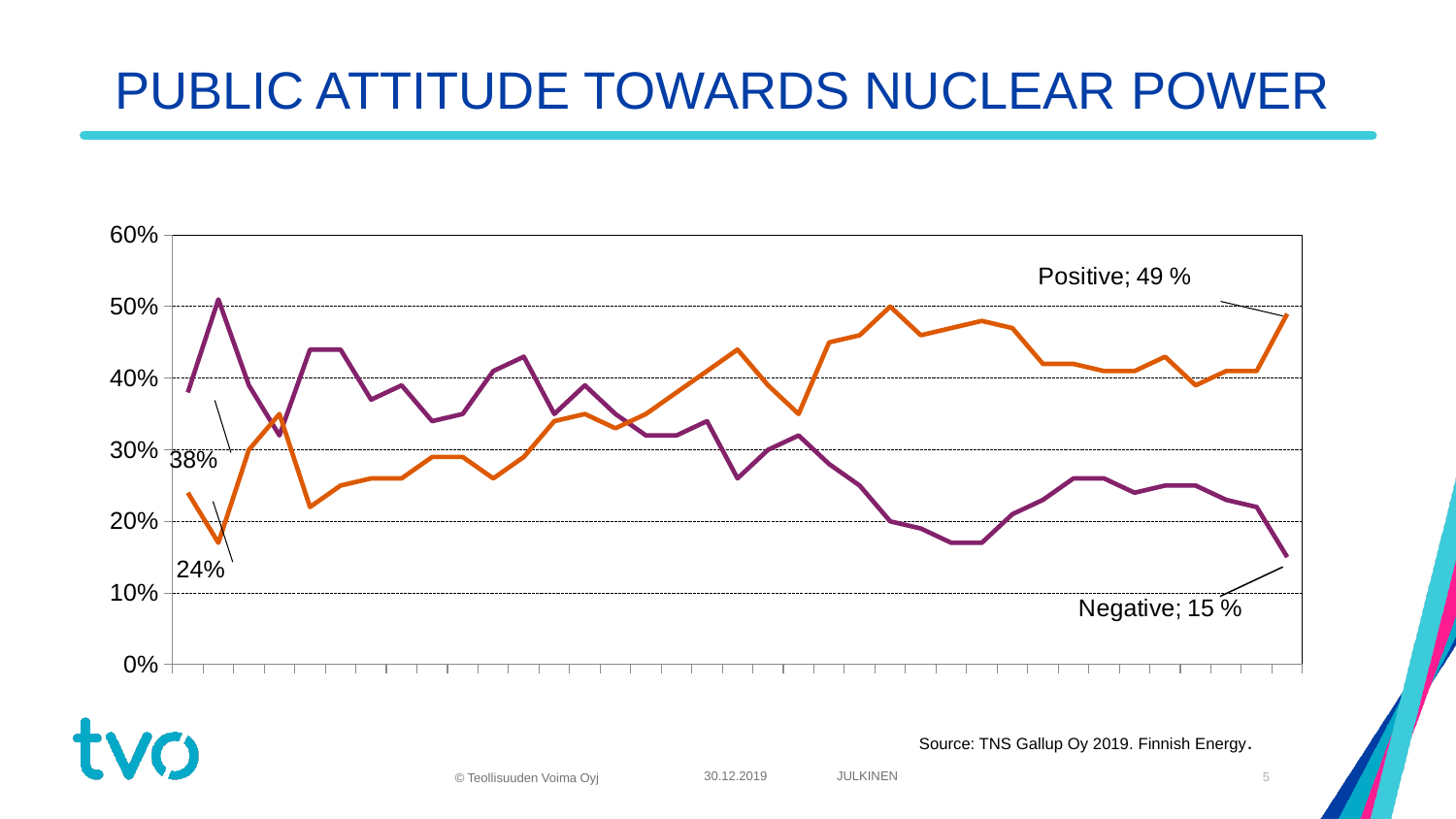
What is the first (leftmost) value of the Negative series? 38% How many data series are plotted in the chart? 2 At the right end of the chart, how much higher is the Positive value than the Negative value? 34 % What is the latest (rightmost) value of the Negative series? 15 % Does the Negative series rise or fall overall from left to right? fall What kind of chart is shown on the slide? line chart Is the lowest value of the Negative series greater or less than 20%? less At the right end of the chart, which series has the larger value, Positive or Negative? Positive What is the title of the chart on the slide? PUBLIC ATTITUDE TOWARDS NUCLEAR POWER At the left end of the chart, how much higher is the Negative value than the Positive value? 14% What is the latest (rightmost) value of the Positive series? 49 % What is the first (leftmost) value of the Positive series? 24%